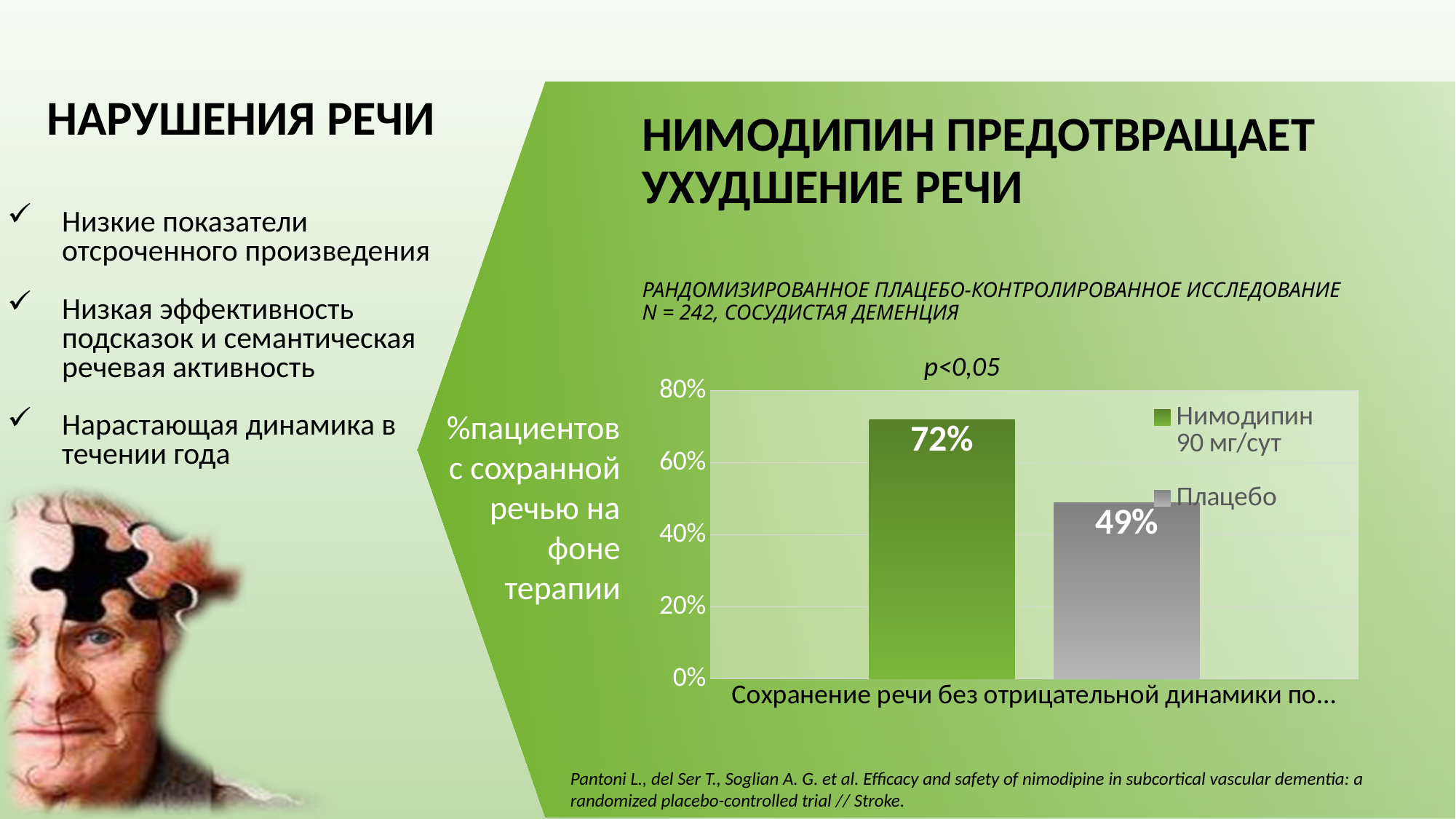
What is the maximum value shown on the vertical axis? 80% Is the value for Плацебо greater or less than 60%? less Is the value for Нимодипин 90 мг/сут greater or less than 60%? greater Which series has the lowest value? Плацебо How many bars are plotted in the chart? 2 What is the value for Нимодипин 90 мг/сут? 72% What kind of chart is shown on the slide? Bar chart What is the value for Плацебо? 49% What p-value is shown above the chart? p<0,05 What is the difference between the Нимодипин 90 мг/сут value and the Плацебо value? 23% How many series does the legend list? 2 Which series has the higher value, Нимодипин 90 мг/сут or Плацебо? Нимодипин 90 мг/сут